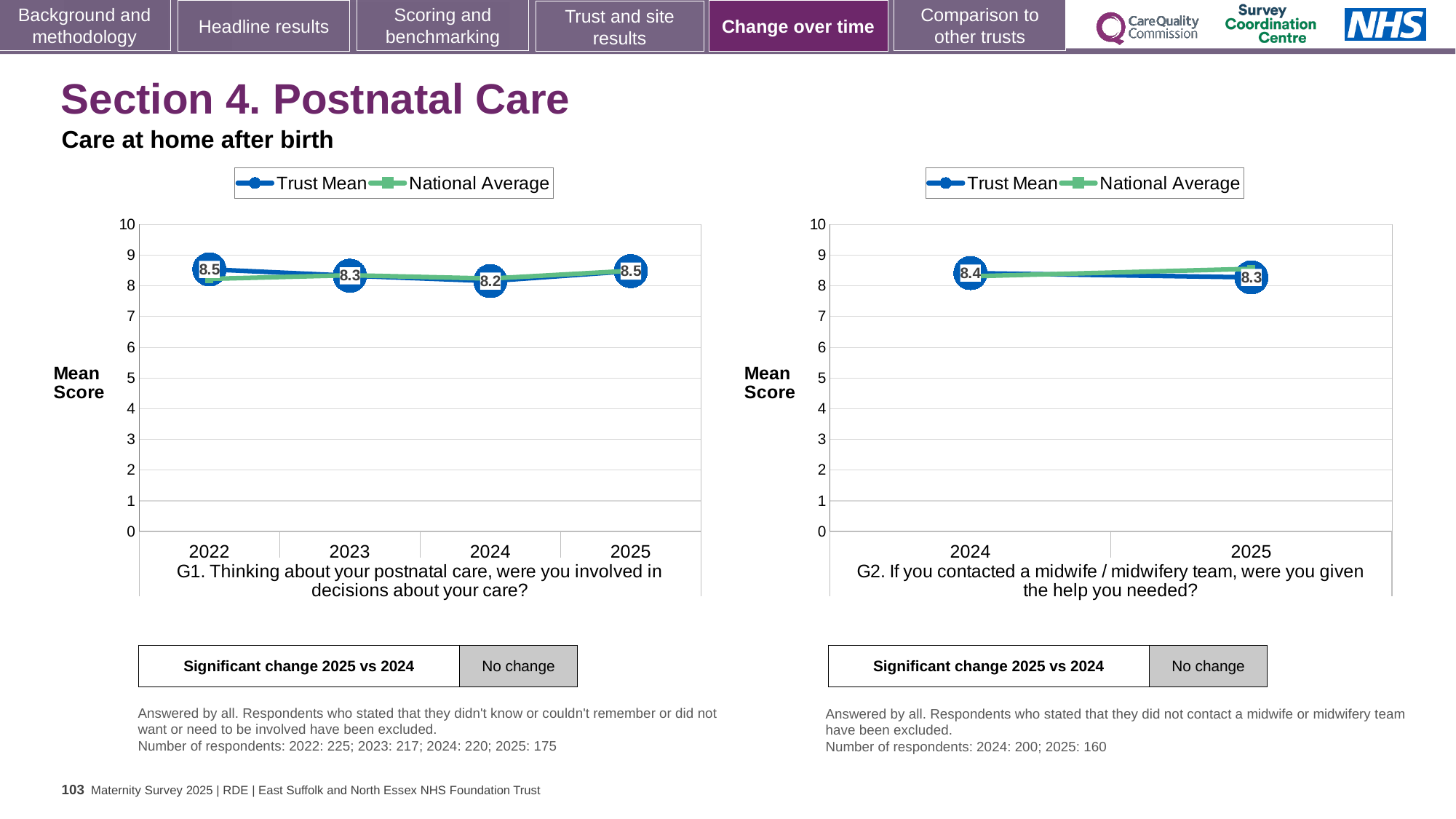
In the G1 chart on the left, what is the Trust Mean for 2024? 8.2 In the G2 chart on the right, is the Trust Mean higher in 2024 or 2025? 2024 In the G1 chart on the left, what is the Trust Mean for 2023? 8.3 What kind of chart is the G1 chart on the left? Line chart In the G2 chart on the right, what is the Trust Mean for 2025? 8.3 In the G1 chart on the left, is the National Average for 2023 greater or less than 5? greater In the G1 chart on the left, what is the Trust Mean for 2022? 8.5 In the G1 chart on the left, what is the difference between the Trust Mean for 2025 and the Trust Mean for 2024? 0.3 How many series does the legend of the G2 chart on the right list? 2 How many years are plotted on the x axis of the G1 chart on the left? 4 In the G1 chart on the left, which year has the lowest Trust Mean? 2024 In the G2 chart on the right, what is the Trust Mean for 2024? 8.4